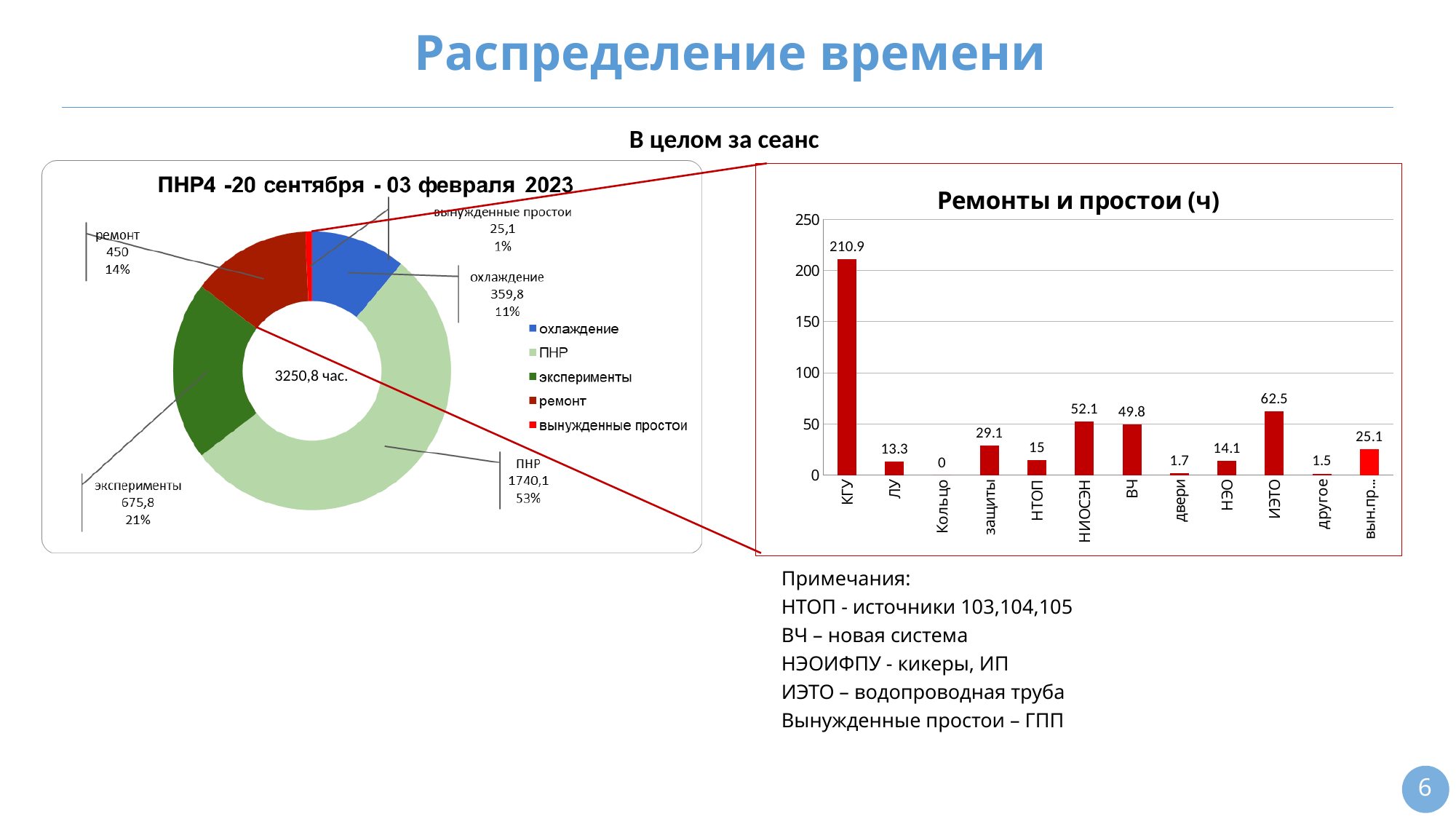
In the chart 'Ремонты и простои (ч)', which is larger, the value for защиты or the value for НТОП? защиты In the chart 'Ремонты и простои (ч)', what is the value for КГУ? 210.9 How many categories are shown on the x axis of the chart 'Ремонты и простои (ч)'? 12 In the chart 'Ремонты и простои (ч)', which category has the lowest value? Кольцо In the chart 'Ремонты и простои (ч)', what is the difference between the values for НИОСЭН and ВЧ? 2.3 In the doughnut chart 'ПНР4 -20 сентября - 03 февраля 2023', what is the value for эксперименты? 675,8 What total is printed in the centre of the doughnut chart 'ПНР4 -20 сентября - 03 февраля 2023'? 3250,8 час. How many entries does the legend of the doughnut chart 'ПНР4 -20 сентября - 03 февраля 2023' list? 5 In the chart 'Ремонты и простои (ч)', which category has the highest value? КГУ In the chart 'Ремонты и простои (ч)', what is the value for ИЭТО? 62.5 What type of chart is 'Ремонты и простои (ч)'? bar chart In the doughnut chart 'ПНР4 -20 сентября - 03 февраля 2023', what share does ПНР have? 53%